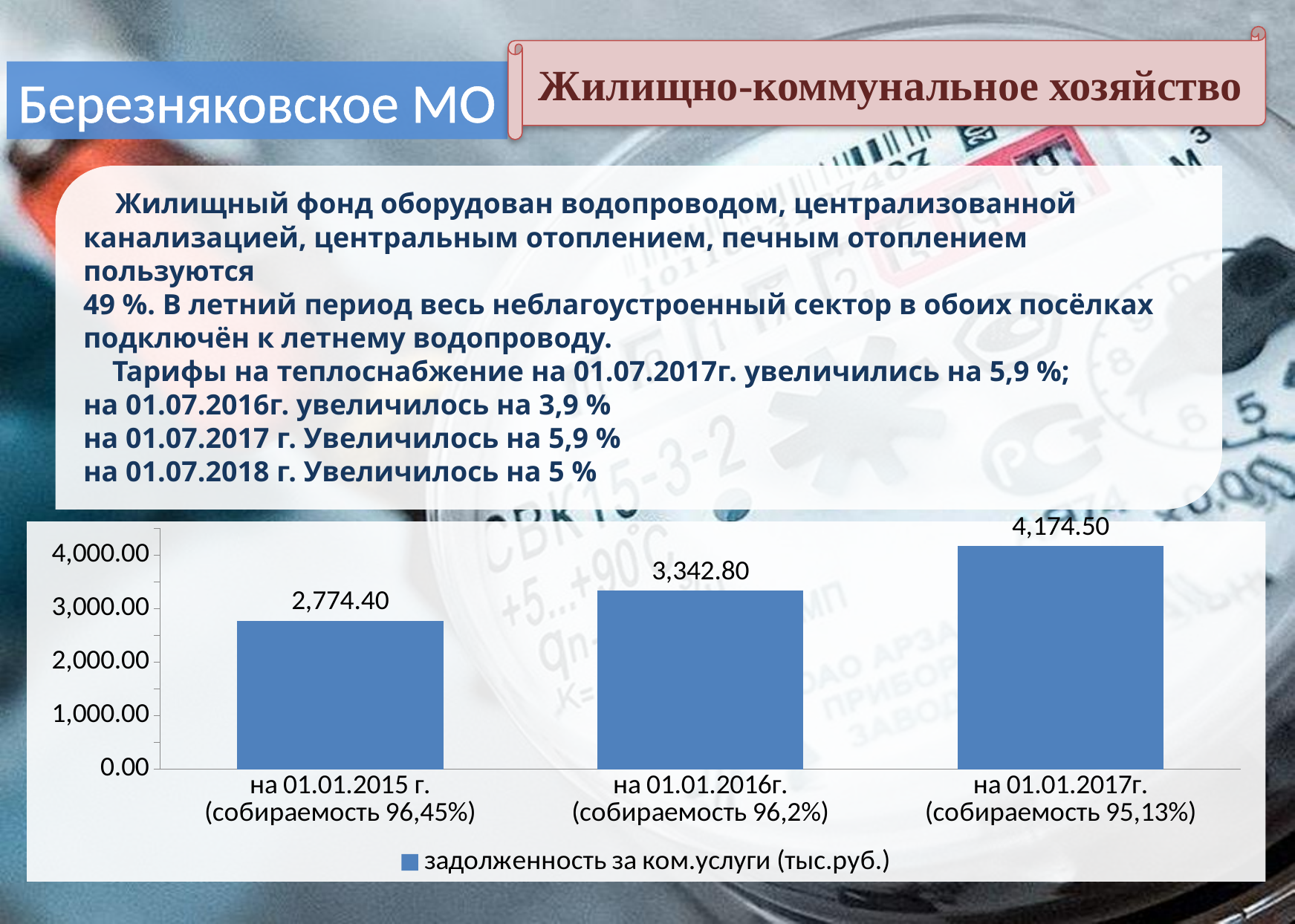
What is the difference between the values for на 01.01.2017г. and на 01.01.2015 г.? 1,400.10 What is the difference between the values for на 01.01.2016г. and на 01.01.2015 г.? 568.40 What is the value of задолженность за ком.услуги for на 01.01.2017г. (собираемость 95,13%)? 4,174.50 Which category has the lowest value in the chart? на 01.01.2015 г. (собираемость 96,45%) Is the value for на 01.01.2017г. greater or less than 4,000.00? greater What is the value of задолженность за ком.услуги for на 01.01.2016г. (собираемость 96,2%)? 3,342.80 Which is larger: the value for на 01.01.2016г. or the value for на 01.01.2017г.? на 01.01.2017г. What is the value of задолженность за ком.услуги for на 01.01.2015 г. (собираемость 96,45%)? 2,774.40 Which category has the highest value in the chart? на 01.01.2017г. (собираемость 95,13%) What kind of chart is shown on the slide? bar chart How many categories are shown in the chart? 3 Do the values rise or fall from на 01.01.2015 г. to на 01.01.2017г.? rise